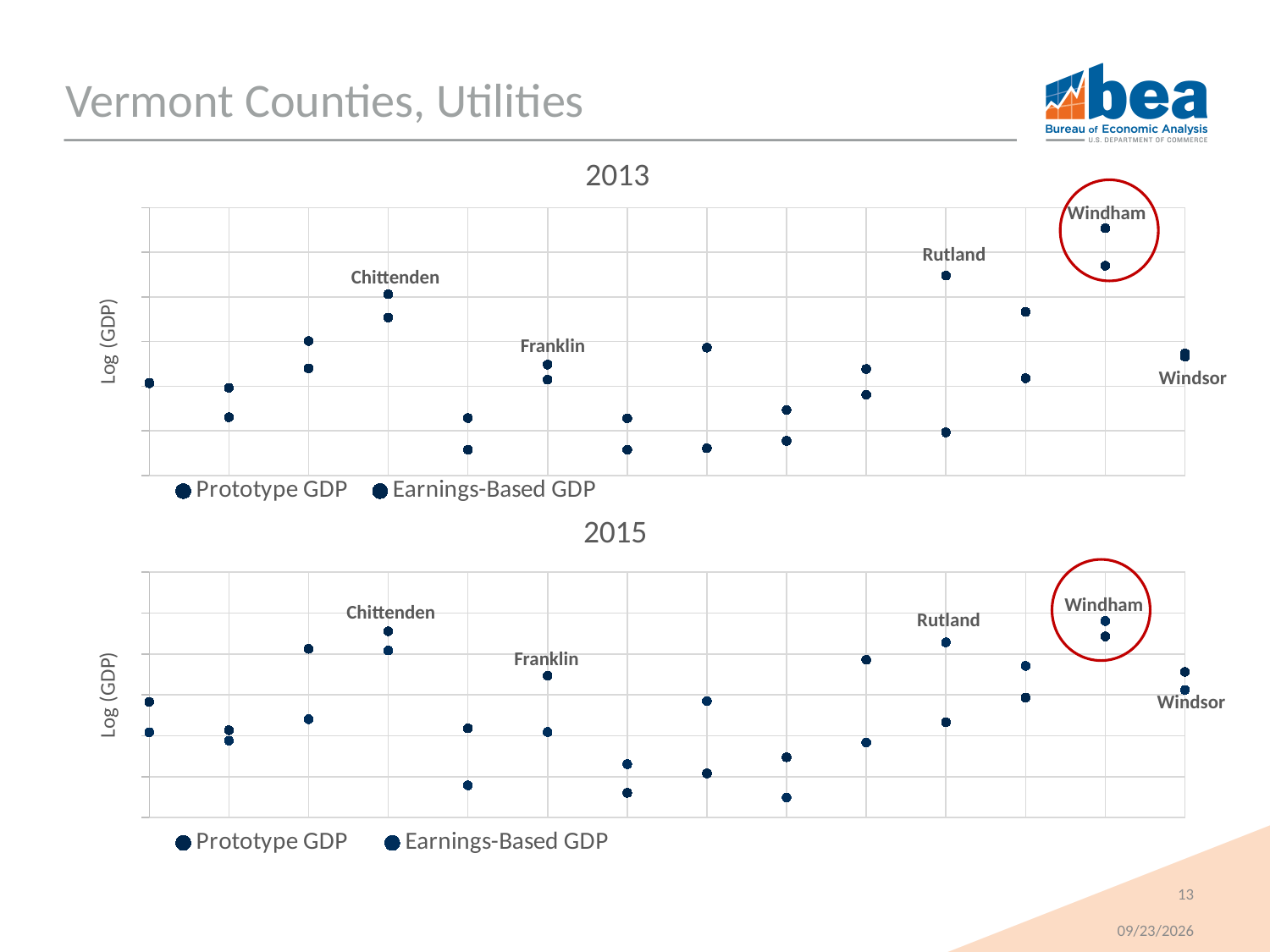
What is the title of the lower chart on the slide? 2015 Which county is circled in red on both the 2013 and 2015 charts? Windham How many series does the legend of the 2015 chart list? 2 In the 2015 chart, which labeled county has higher plotted values, Chittenden or Franklin? Chittenden In the 2013 chart, which labeled county has the highest plotted points? Windham In the 2013 chart, which labeled county has higher plotted values, Chittenden or Franklin? Chittenden In the 2015 chart, which labeled county has higher plotted values, Windham or Windsor? Windham What are the two series named in the legend of the 2013 chart? Prototype GDP and Earnings-Based GDP How many counties (x positions) are plotted in the 2013 chart? 14 What kind of chart is the 2013 chart on the slide? Scatter chart